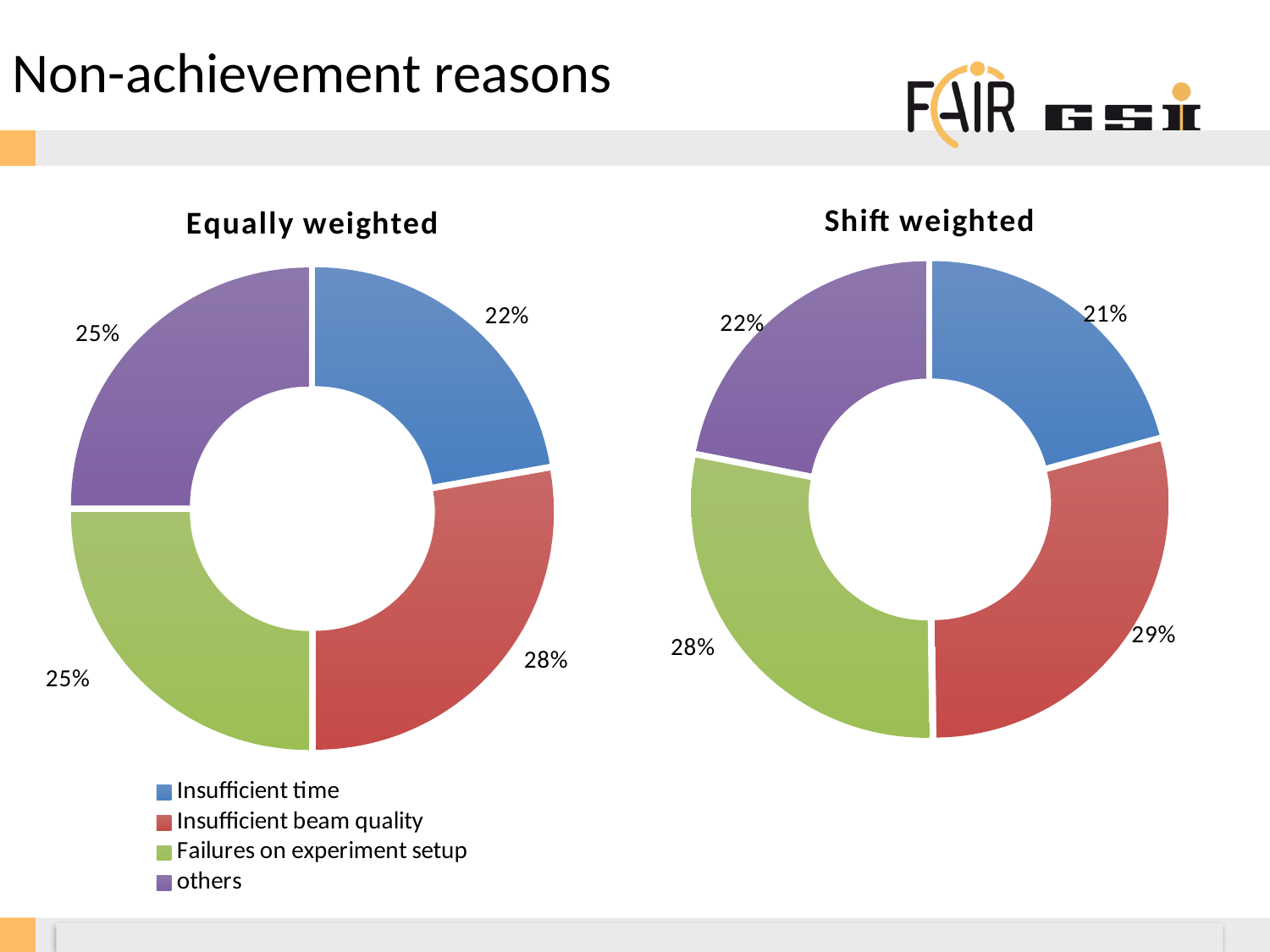
Which colour represents 'others' in the legend? Purple In the 'Equally weighted' chart, which category has the smallest share? Insufficient time In the 'Shift weighted' chart, which category has the smallest share? Insufficient time In the 'Equally weighted' chart, what is the difference between the shares for Insufficient beam quality and others? 3% What kind of chart is the 'Shift weighted' chart? Doughnut chart In the 'Equally weighted' chart, which category has the largest share? Insufficient beam quality In the 'Shift weighted' chart, what share is labelled for Insufficient time? 21% How many categories does the 'Equally weighted' chart show? 4 In the 'Shift weighted' chart, which is larger: the share for others or the share for Failures on experiment setup? Failures on experiment setup In the 'Shift weighted' chart, what share is labelled for Failures on experiment setup? 28% In the 'Equally weighted' chart, what share is labelled for Insufficient beam quality? 28% In the 'Shift weighted' chart, what is the difference between the shares for Insufficient beam quality and Insufficient time? 8%